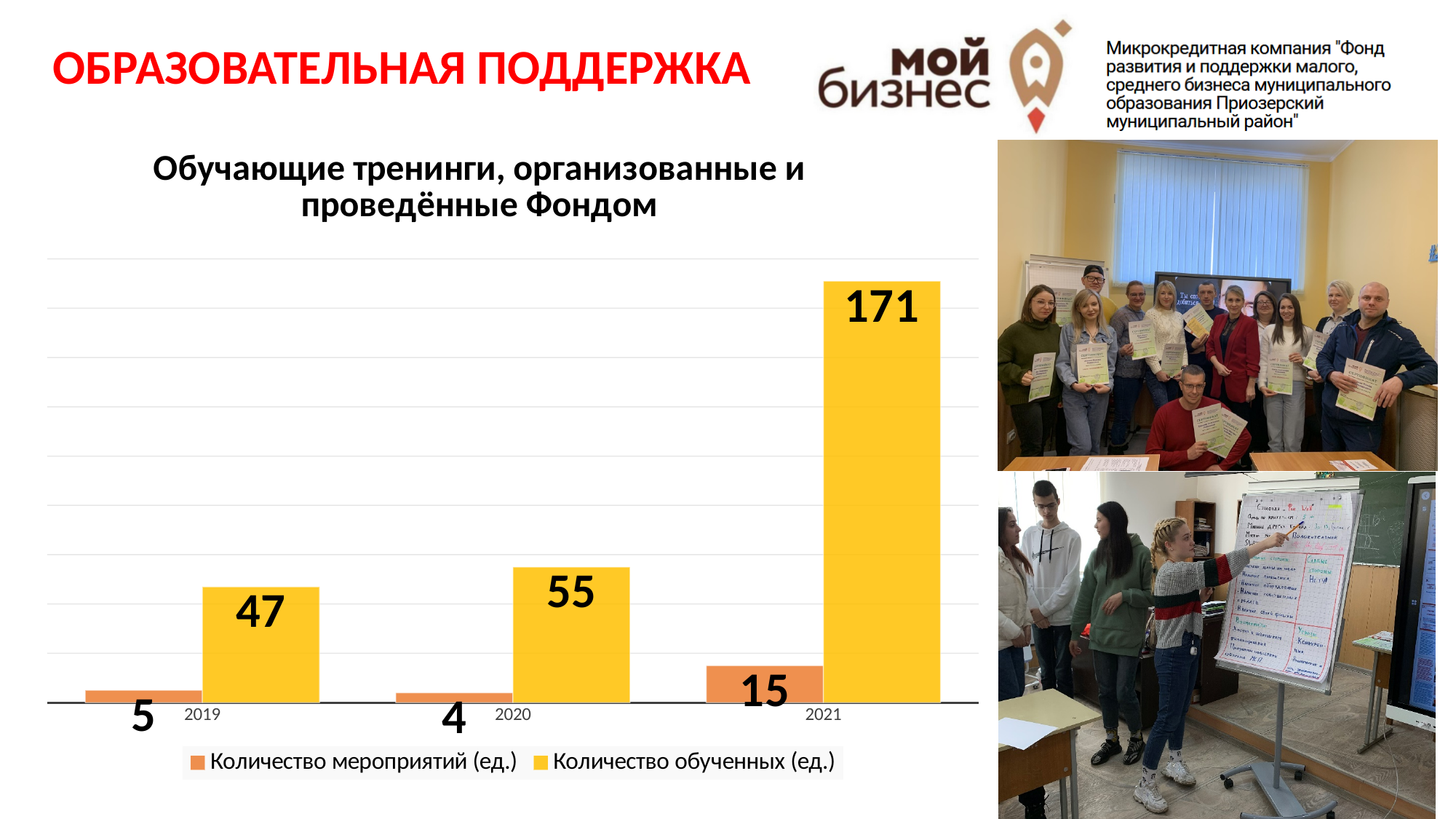
How many years are shown on the x axis of the chart? 3 How many series does the chart legend list? 2 What is the value of "Количество обученных (ед.)" for 2021? 171 In which year is "Количество мероприятий (ед.)" the lowest? 2020 What is the difference between "Количество обученных (ед.)" in 2021 and in 2020? 116 What is the value of "Количество мероприятий (ед.)" for 2019? 5 Which is larger: "Количество обученных (ед.)" in 2019 or in 2020? 2020 What is the value of "Количество обученных (ед.)" for 2020? 55 In which year is "Количество обученных (ед.)" the highest? 2021 What is the title of the chart? Обучающие тренинги, организованные и проведённые Фондом What is the value of "Количество мероприятий (ед.)" for 2021? 15 What kind of chart is shown on the slide? Bar chart